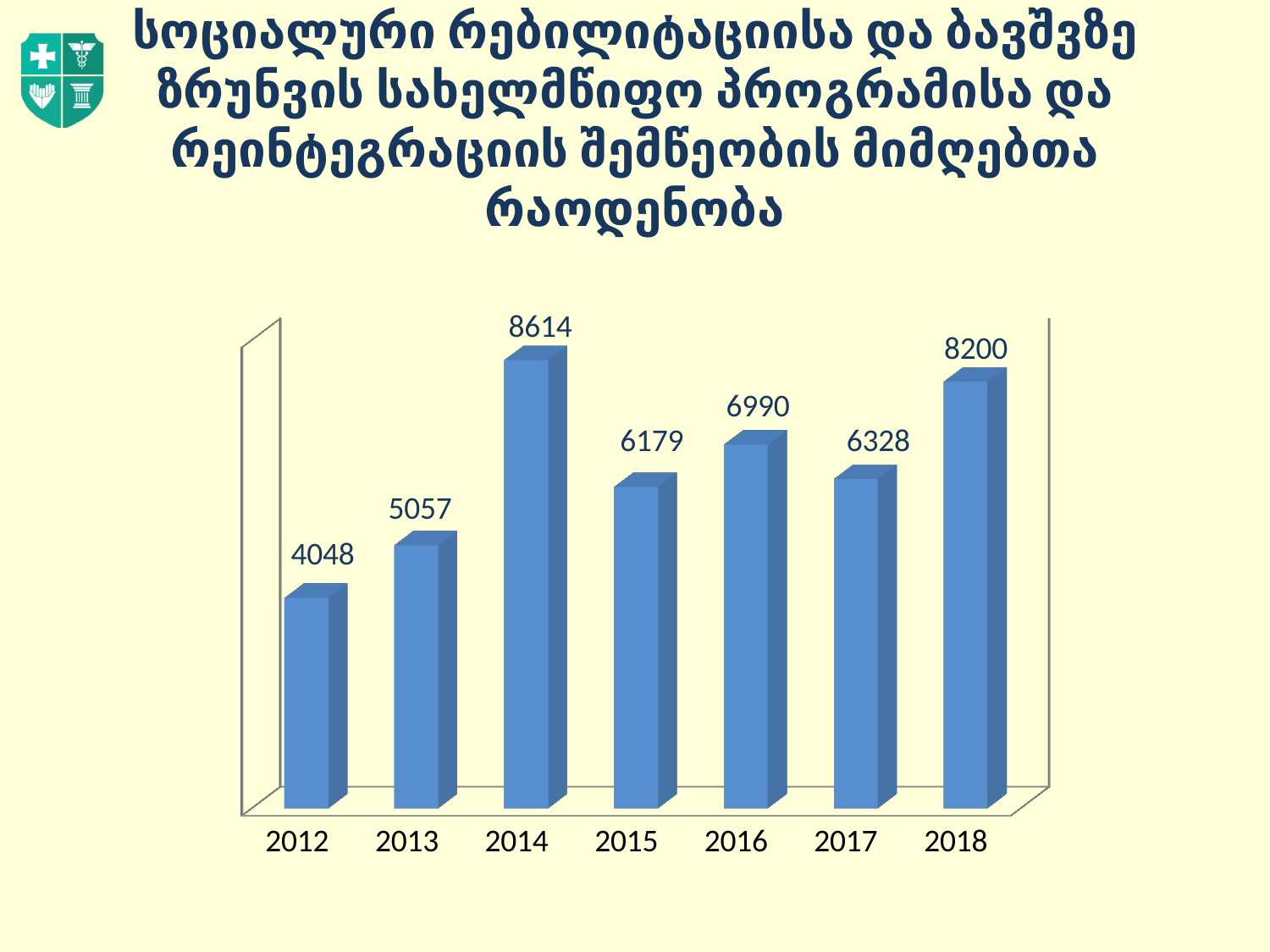
What kind of chart is shown on the slide? bar chart What is the difference between the values for 2014 and 2018? 414 Which year has the highest value? 2014 Which year has the lowest value? 2012 What is the value for 2014? 8614 Which is larger, the value for 2016 or the value for 2017? 2016 Does the value rise or fall from 2014 to 2015? fall What is the value for 2017? 6328 How many years are shown on the x axis? 7 What is the difference between the values for 2013 and 2012? 1009 What colour are the bars in the chart? blue What is the value for 2012? 4048